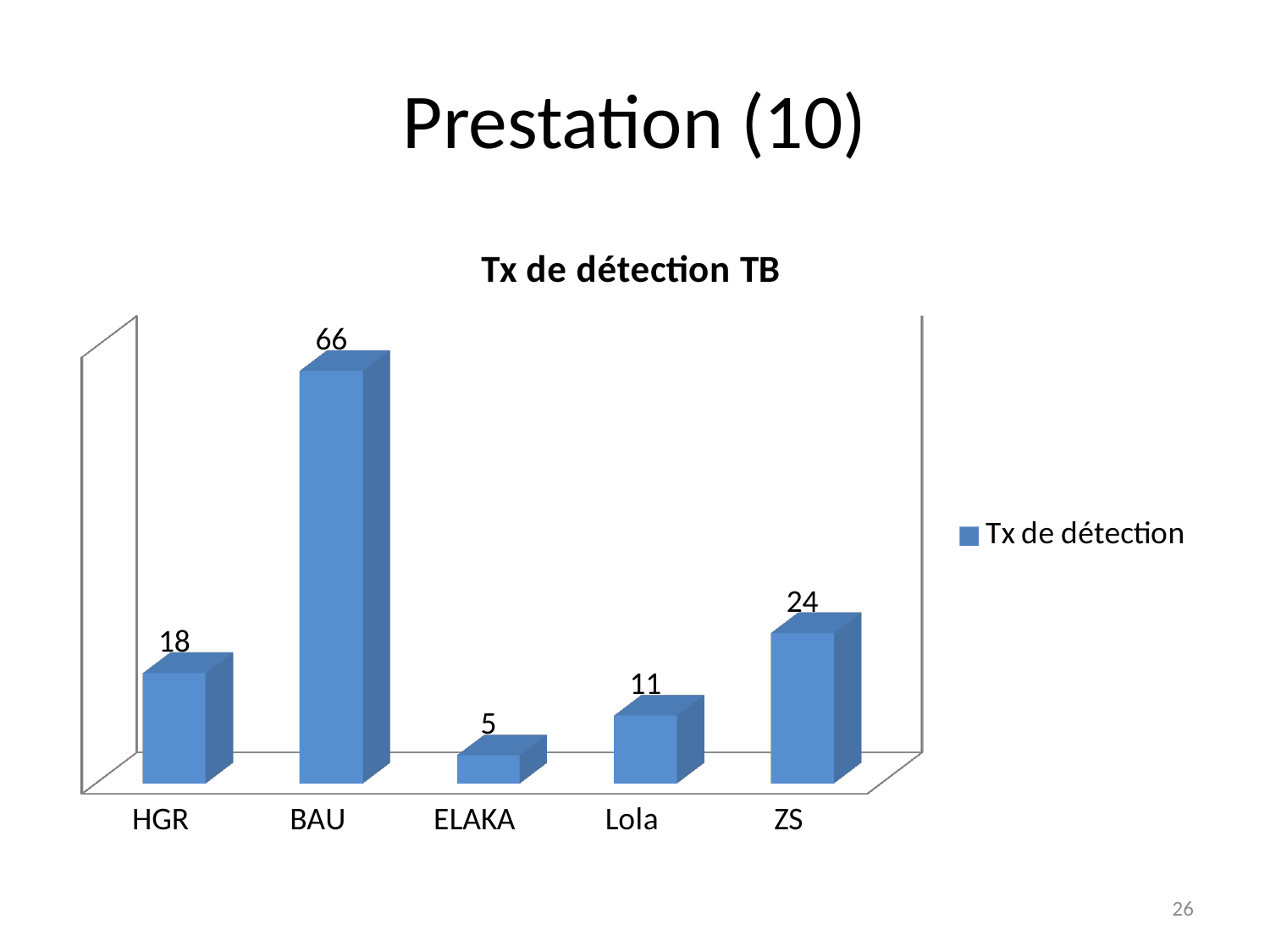
How many series does the legend list? 1 What kind of chart is shown? bar chart Which category has the highest value? BAU What is the value for ZS? 24 What is the value for ELAKA? 5 Which is larger, the value for HGR or the value for Lola? HGR Which category has the lowest value? ELAKA What is the difference between the values for BAU and ZS? 42 How many categories are shown on the x axis? 5 What is the value for BAU? 66 What is the difference between the values for HGR and Lola? 7 What is the title of the chart? Tx de détection TB